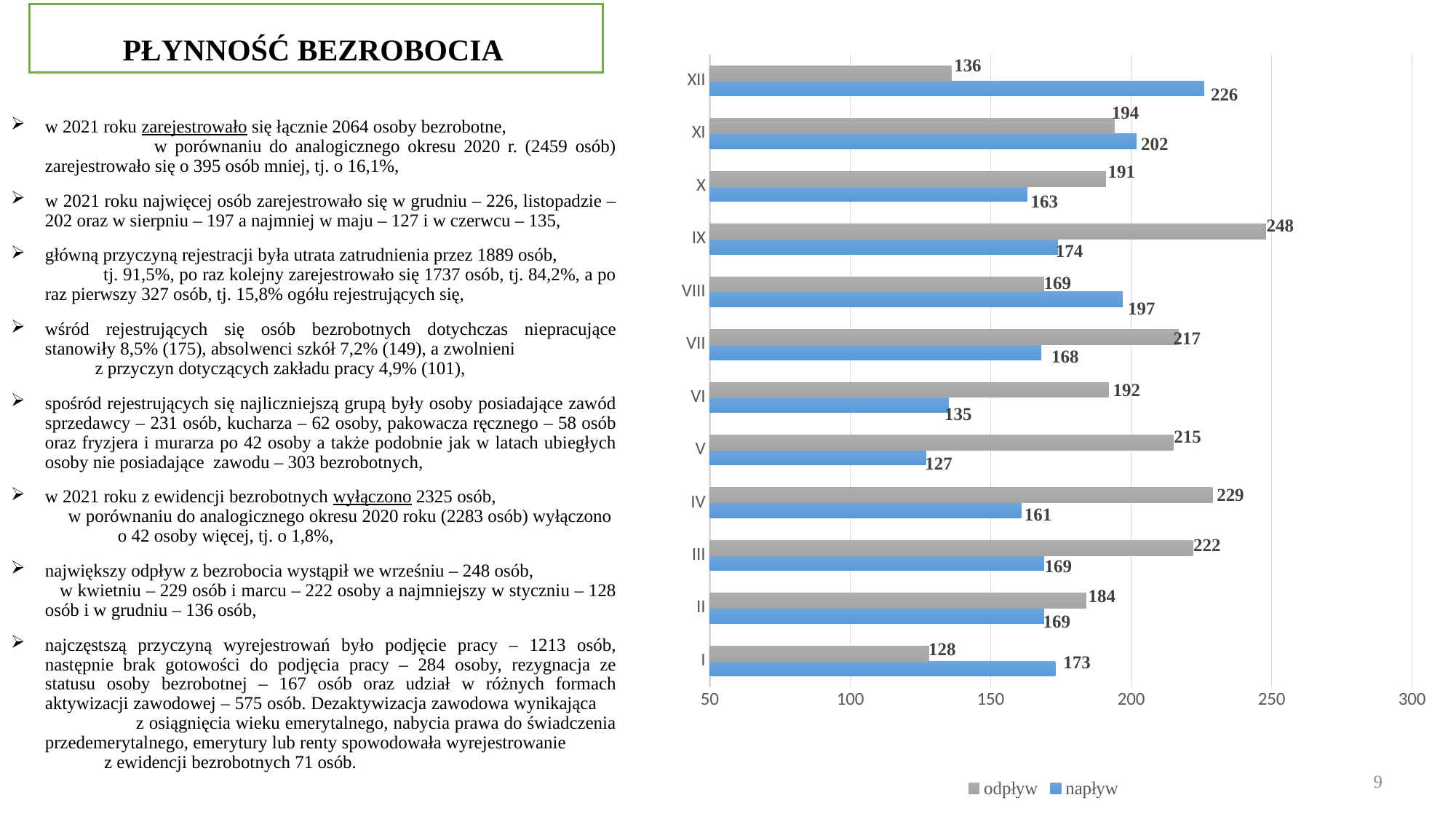
Is the odpływ value for month IV greater or less than 200? greater How many months (categories) are shown on the chart? 12 What is the odpływ value for month IX? 248 Which month has the highest odpływ value? IX What is the difference between the odpływ and napływ values for month IX? 74 What is the napływ value for month V? 127 What kind of chart is shown on the slide? bar chart Which month has the lowest napływ value? V For month VIII, which is larger: odpływ or napływ? napływ What is the napływ value for month XII? 226 How many series does the legend list? 2 Which month has the lowest odpływ value? I